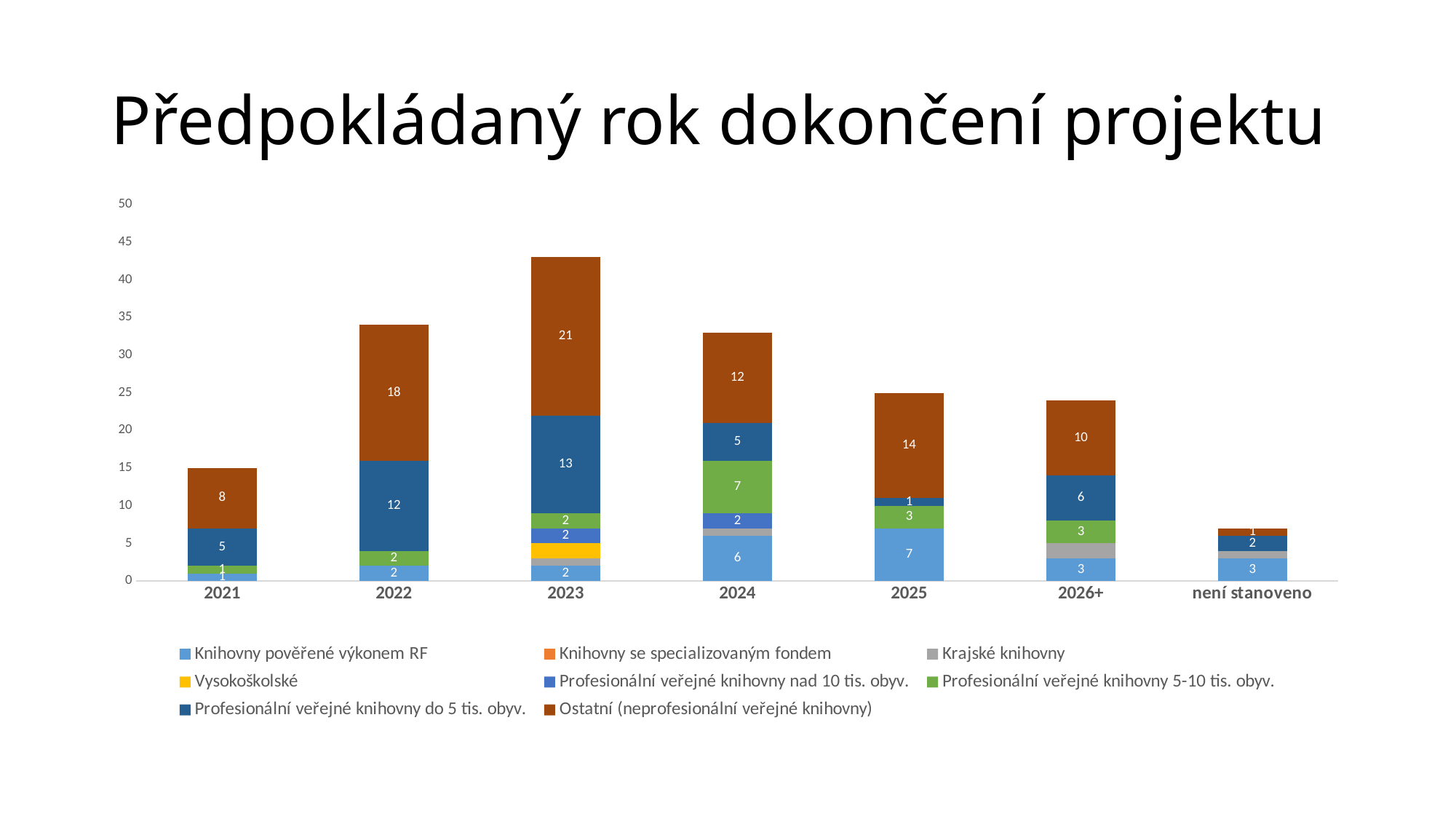
What kind of chart is shown on the slide? stacked bar chart What is the value for Profesionální veřejné knihovny do 5 tis. obyv. in 2022? 12 What is the value for Profesionální veřejné knihovny 5-10 tis. obyv. in 2024? 7 What is the total of the stacked bar for 2022? 34 Which category has the tallest stacked bar overall? 2023 Which category has the shortest stacked bar overall? není stanoveno Is the total of the stacked bar for 2023 greater or less than 40? greater How many series does the legend list? 8 What is the value for Ostatní (neprofesionální veřejné knihovny) in 2023? 21 What is the difference between the Ostatní (neprofesionální veřejné knihovny) values for 2023 and 2022? 3 What is the total of the stacked bar for 2021? 15 How many categories are shown on the x axis? 7